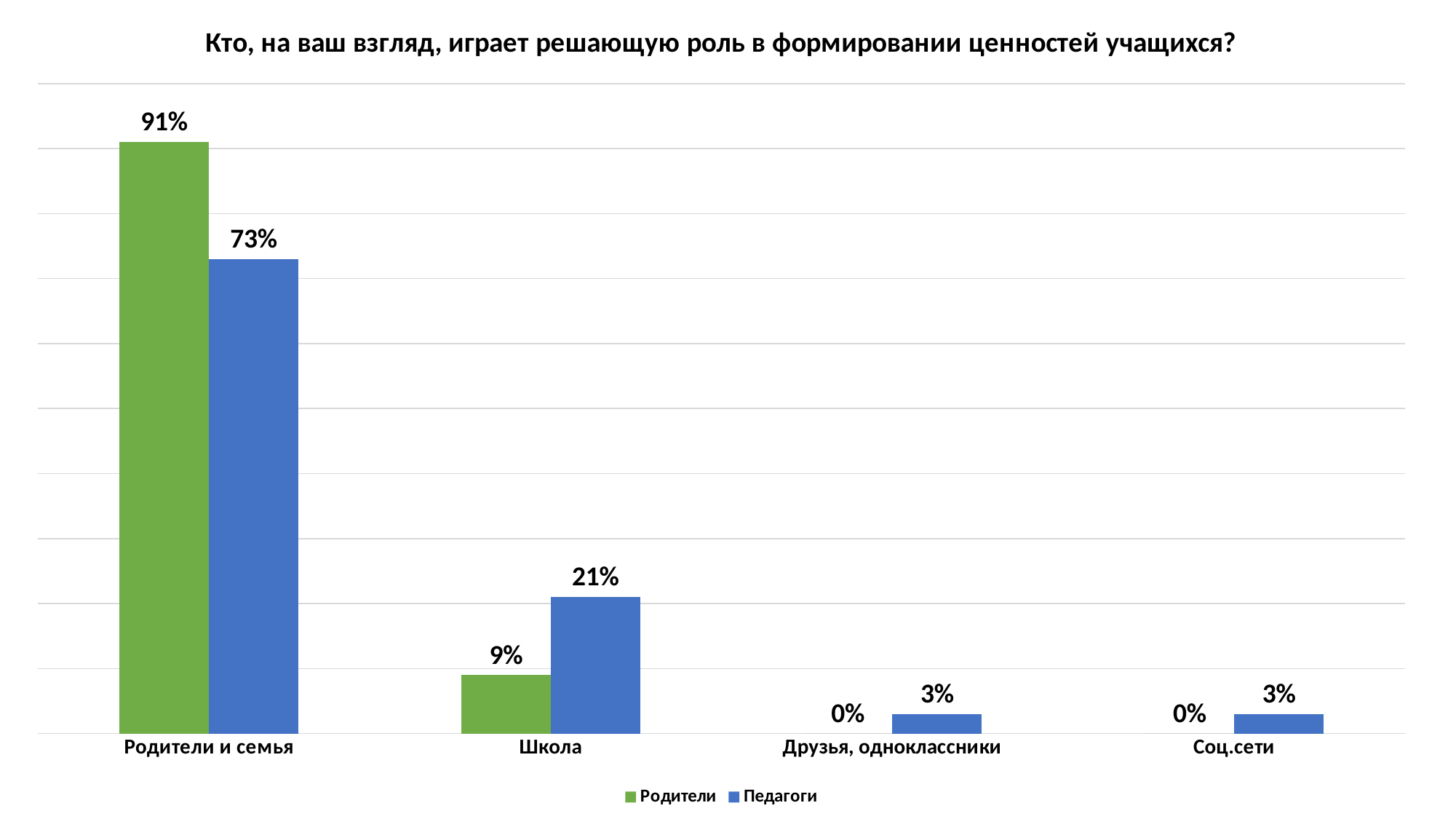
How many categories are shown on the x axis? 4 What kind of chart is shown on the slide? Bar chart How many series does the legend list? 2 In the Школа category, which series has the larger value, Родители or Педагоги? Педагоги What is the difference between the Педагоги and Родители values in the Школа category? 12% What is the difference between the Родители and Педагоги values in the Родители и семья category? 18% What value is shown for Родители in the Соц.сети category? 0% What value is shown for Педагоги in the Школа category? 21% Which colour represents the Педагоги series? Blue Which category has the lowest value for Педагоги? Друзья, одноклассники and Соц.сети (both 3%) Which category has the highest value for Педагоги? Родители и семья What value is shown for Родители in the Родители и семья category? 91%